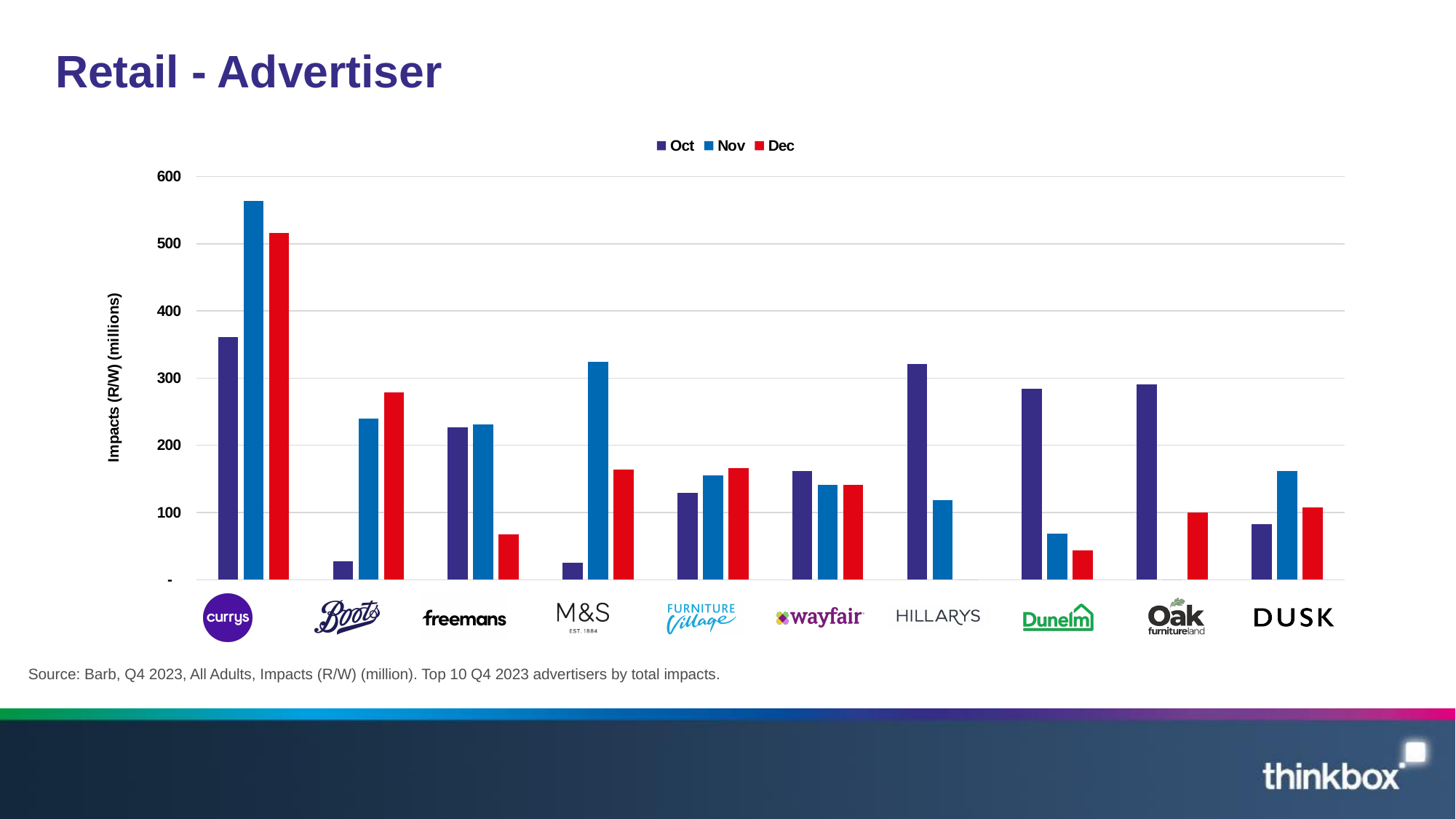
Is the Oct value for Dunelm greater or less than 200? greater For Hillarys, which is larger: the Oct value or the Nov value? Oct Which advertiser has the highest Nov value? Currys How many advertisers are shown on the x axis? 10 Which advertiser has the highest Oct value? Currys For M&S, which is larger: the Nov value or the Dec value? Nov What is the label on the y axis? Impacts (R/W) (millions) How many series does the legend list? 3 Is the Nov value for Currys greater or less than 500? greater What type of chart is shown on the slide? bar chart Is the Dec value for Oak Furnitureland greater or less than 200? less